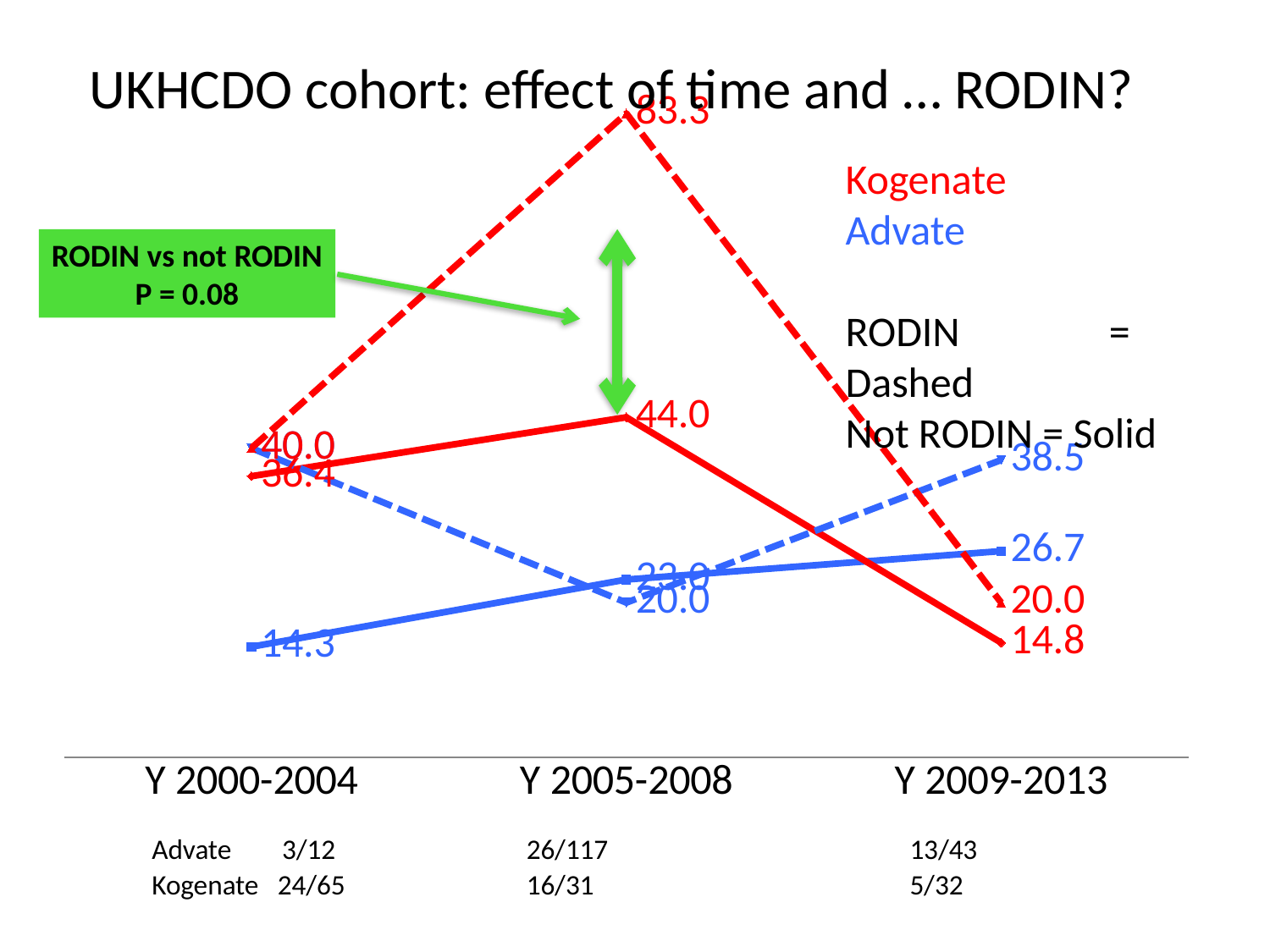
What is the value of the dashed Kogenate (RODIN) line at Y 2005-2008? 83.3 How many time periods are shown along the x axis? 3 Does the solid Advate (not RODIN) line rise or fall from Y 2000-2004 to Y 2009-2013? rises What is the value of the dashed Advate (RODIN) line at Y 2009-2013? 38.5 What is the value of the solid Advate (not RODIN) line at Y 2009-2013? 26.7 What is the value of the solid Kogenate (not RODIN) line at Y 2005-2008? 44.0 At Y 2009-2013, which is larger: the dashed Advate value or the dashed Kogenate value? dashed Advate (38.5) What type of chart is shown on the slide? line chart What is the difference between the dashed and solid Kogenate values at Y 2005-2008? 39.3 What is the value of the solid Kogenate (not RODIN) line at Y 2009-2013? 14.8 Which line reaches the highest plotted value on the chart? Kogenate RODIN (dashed red), 83.3 According to the legend, what does a dashed line represent? RODIN